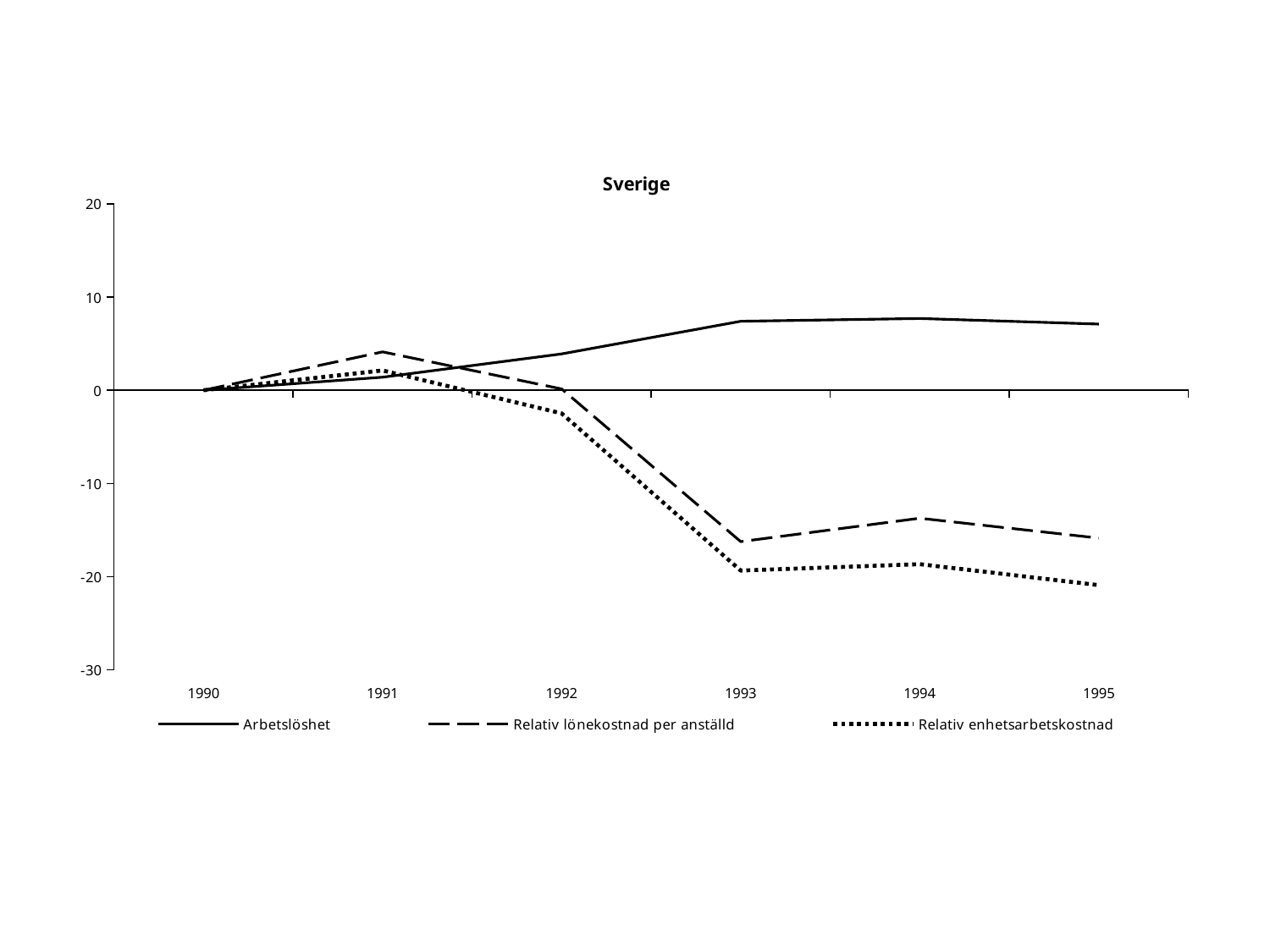
Which series has the highest value in 1995? Arbetslöshet Is the value of Arbetslöshet in 1993 greater or less than 0? greater Does Relativ enhetsarbetskostnad rise or fall from 1992 to 1993? fall How many series does the legend list? 3 Is the value of Arbetslöshet in 1994 greater or less than 10? less What is the title of the chart? Sverige What is the value of Arbetslöshet in 1990? 0 How many years are shown on the x axis? 6 Is the value of Relativ lönekostnad per anställd in 1993 greater or less than -10? less Which series has the lowest value in 1995? Relativ enhetsarbetskostnad In 1993, which is larger: Arbetslöshet or Relativ lönekostnad per anställd? Arbetslöshet What kind of chart is shown on the slide? line chart